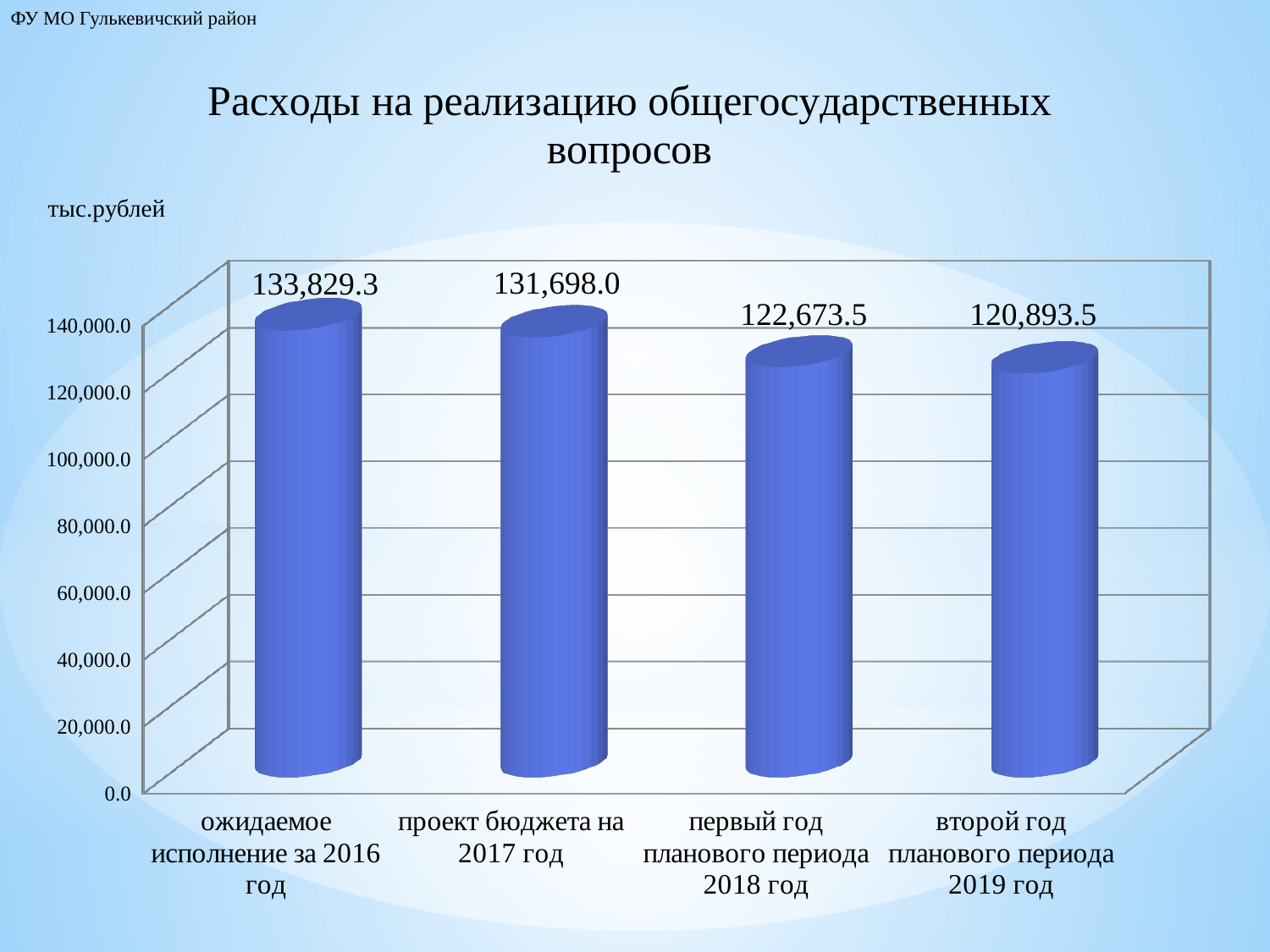
Which category has the lowest value? второй год планового периода 2019 год What is the difference between the values for 'первый год планового периода 2018 год' and 'второй год планового периода 2019 год'? 1,780.0 What is the value for 'первый год планового периода 2018 год'? 122,673.5 Which is larger: the value for 'проект бюджета на 2017 год' or the value for 'первый год планового периода 2018 год'? проект бюджета на 2017 год What kind of chart is shown on the slide? bar chart What is the difference between the values for 'ожидаемое исполнение за 2016 год' and 'проект бюджета на 2017 год'? 2,131.3 Do the values rise or fall from left to right along the x axis? fall How many categories are shown on the chart? 4 What is the value for 'проект бюджета на 2017 год'? 131,698.0 What is the value for 'ожидаемое исполнение за 2016 год'? 133,829.3 Which category has the highest value? ожидаемое исполнение за 2016 год What is the value for 'второй год планового периода 2019 год'? 120,893.5